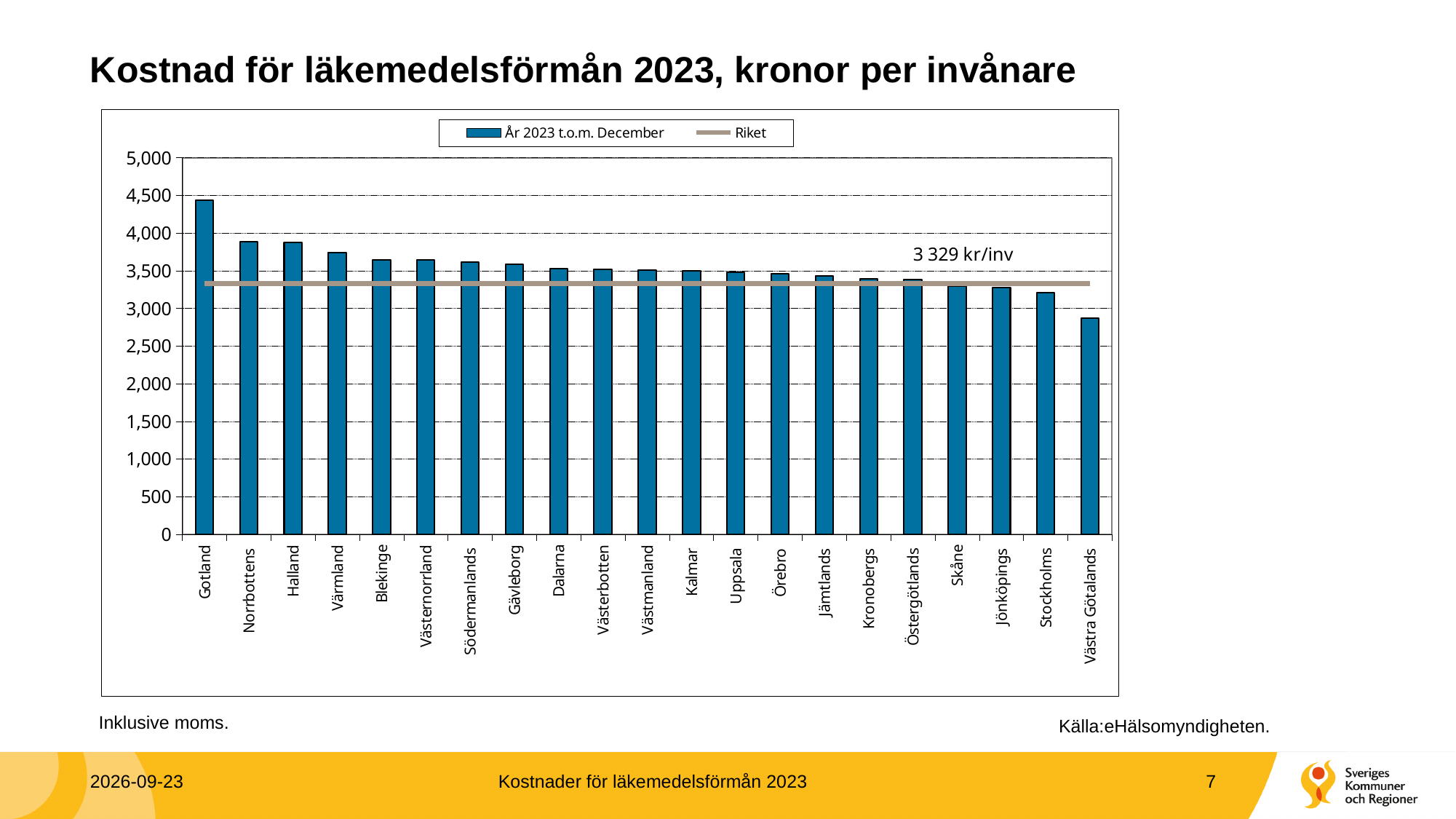
Is the value for Stockholms greater or less than 3,000? greater Which region has the highest cost per inhabitant in the chart? Gotland Is the value for Gotland greater or less than 4,000? greater Which region has the lowest cost per inhabitant in the chart? Västra Götalands What is the value of the Riket (national) reference line shown on the chart? 3 329 kr/inv How many regions are shown on the x axis of the chart? 21 Is the value for Västra Götalands greater or less than 3,000? less Do the bar values rise or fall from left to right along the x axis? fall How many entries does the chart legend list? 2 What kind of chart is shown on the slide? bar chart Which has the larger value, Värmland or Jönköpings? Värmland Which has the larger value, Gotland or Halland? Gotland